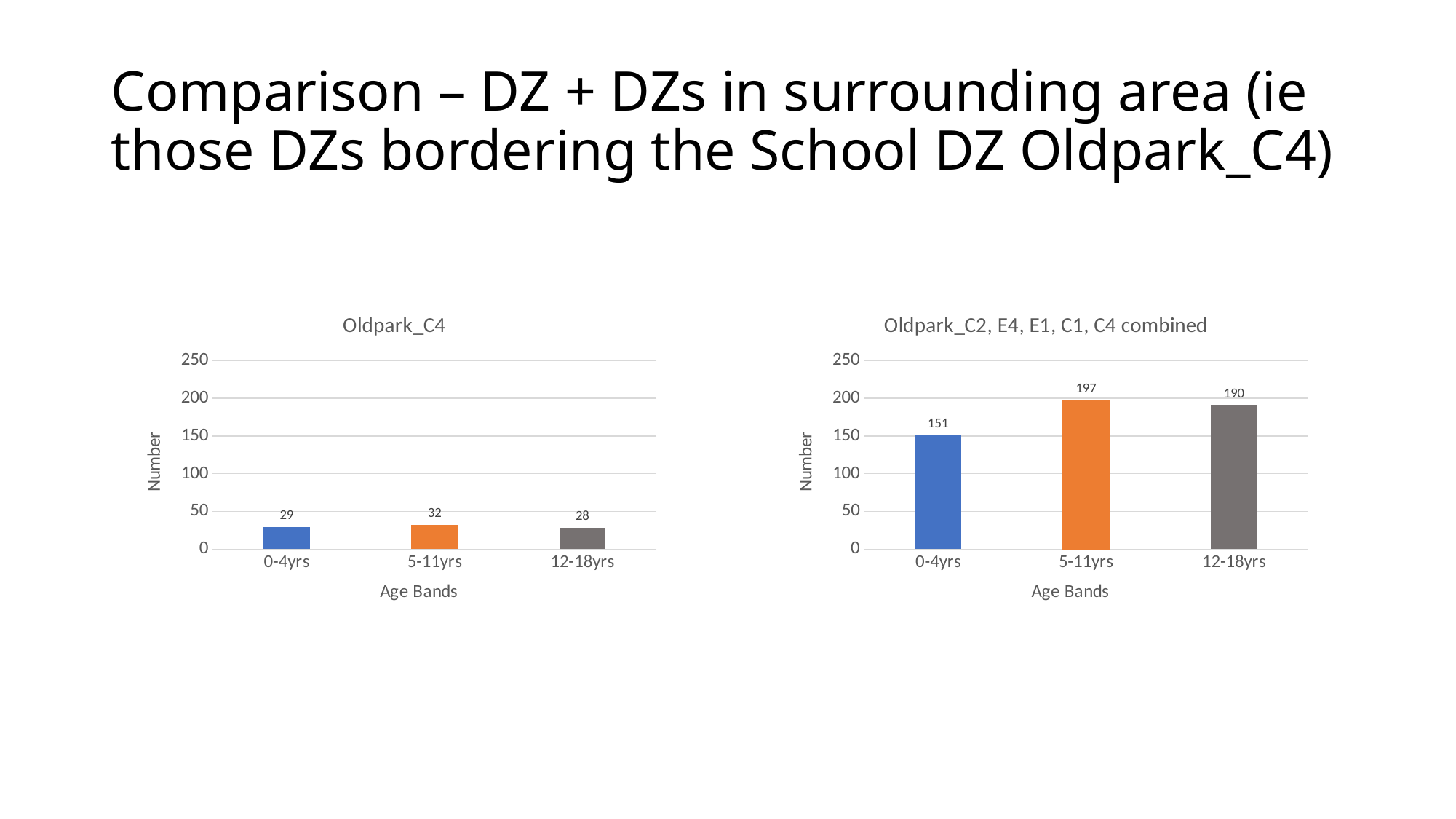
In the Oldpark_C2, E4, E1, C1, C4 combined chart, what is the difference between the 5-11yrs and 12-18yrs values? 7 In the Oldpark_C2, E4, E1, C1, C4 combined chart, what is the value for 0-4yrs? 151 In the Oldpark_C4 chart, what is the difference between the 0-4yrs and 12-18yrs values? 1 What kind of chart is the Oldpark_C2, E4, E1, C1, C4 combined chart? bar chart In the Oldpark_C2, E4, E1, C1, C4 combined chart, is the value for 0-4yrs greater or less than 200? less In the Oldpark_C2, E4, E1, C1, C4 combined chart, what is the value for 5-11yrs? 197 In the Oldpark_C4 chart, what is the value for 12-18yrs? 28 In the Oldpark_C4 chart, what is the value for 5-11yrs? 32 In the Oldpark_C2, E4, E1, C1, C4 combined chart, which age band has the lowest value? 0-4yrs What is the y-axis label on the Oldpark_C4 chart? Number How many age bands are shown in the Oldpark_C4 chart? 3 In the Oldpark_C4 chart, which age band has the highest value? 5-11yrs